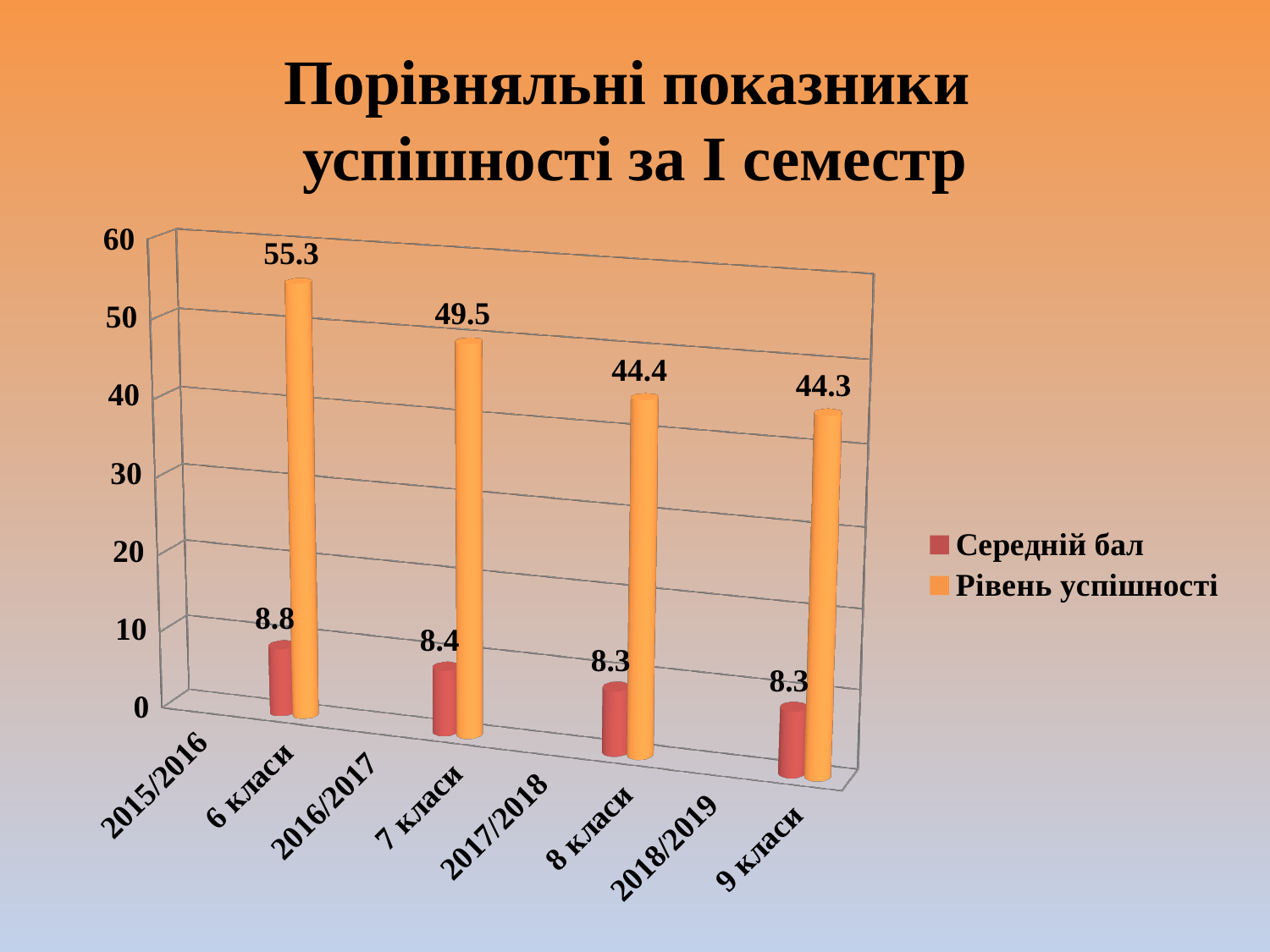
What is the difference in Середній бал between 2015/2016 6 класи and 2017/2018 8 класи? 0.5 Which category has the highest Середній бал? 2015/2016 6 класи How many categories are shown on the x axis? 8 What is the difference in Рівень успішності between 2015/2016 6 класи and 2016/2017 7 класи? 5.8 What kind of chart is shown on the slide? bar chart What is the value of Рівень успішності for 2018/2019 9 класи? 44.3 Which is larger: Рівень успішності for 2016/2017 7 класи or for 2017/2018 8 класи? 2016/2017 7 класи Does Рівень успішності rise or fall across the categories from 2015/2016 to 2018/2019? fall How many series does the legend list? 2 What is the value of Рівень успішності for 2015/2016 6 класи? 55.3 Which category has the highest Рівень успішності? 2015/2016 6 класи What is the value of Середній бал for 2016/2017 7 класи? 8.4